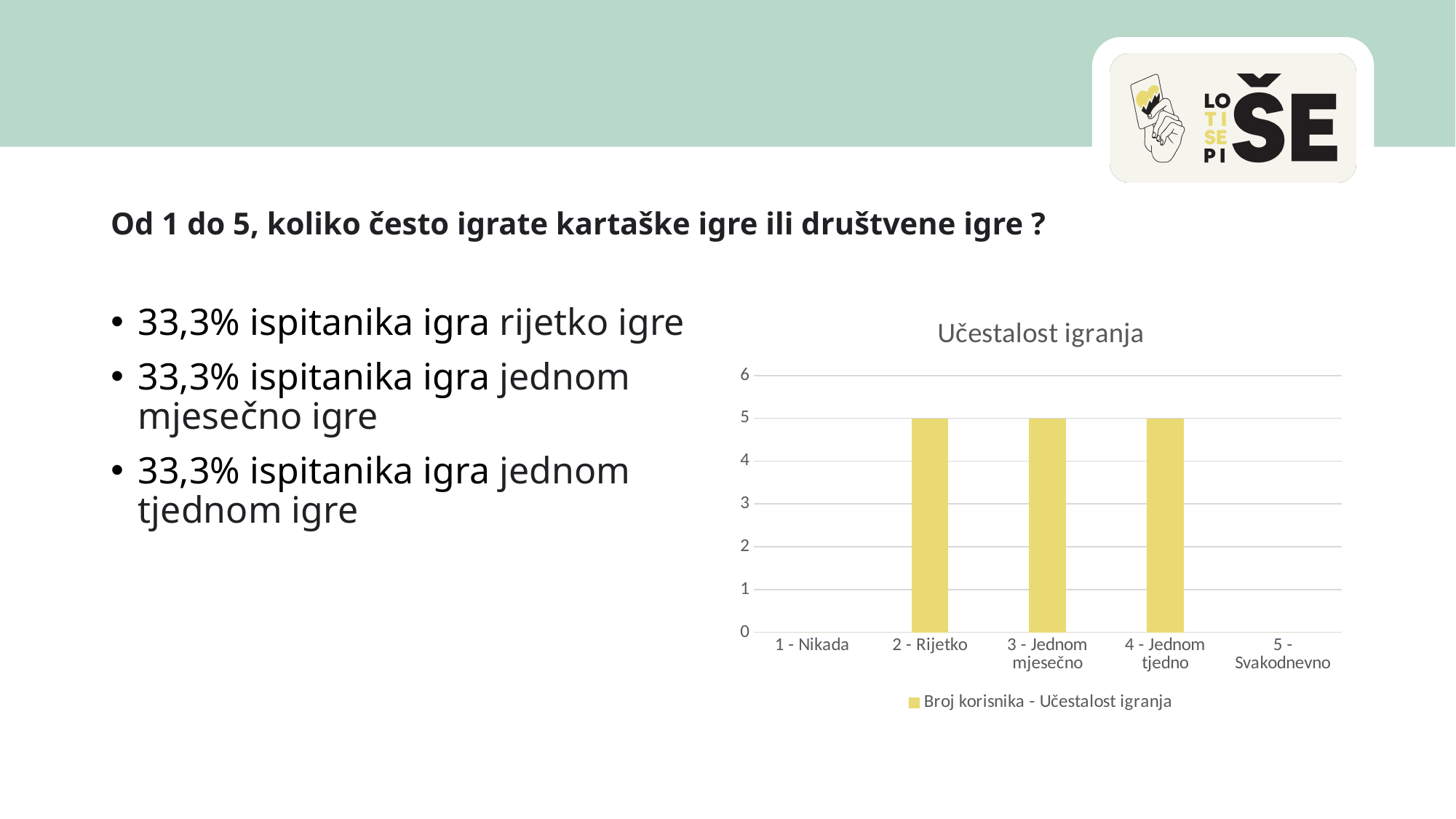
How many series does the chart legend list? 1 What is the value for "1 - Nikada"? 0 Which is larger, the value for "2 - Rijetko" or the value for "5 - Svakodnevno"? 2 - Rijetko What is the difference between the value for "4 - Jednom tjedno" and the value for "1 - Nikada"? 5 What is the value for "2 - Rijetko"? 5 How many categories are shown on the x axis of the chart? 5 What kind of chart is shown on the slide? bar chart What is the value for "3 - Jednom mjesečno"? 5 What is the legend entry for the series in the chart? Broj korisnika - Učestalost igranja What is the value for "4 - Jednom tjedno"? 5 Is the value for "3 - Jednom mjesečno" greater or less than 3? greater What is the title of the chart? Učestalost igranja